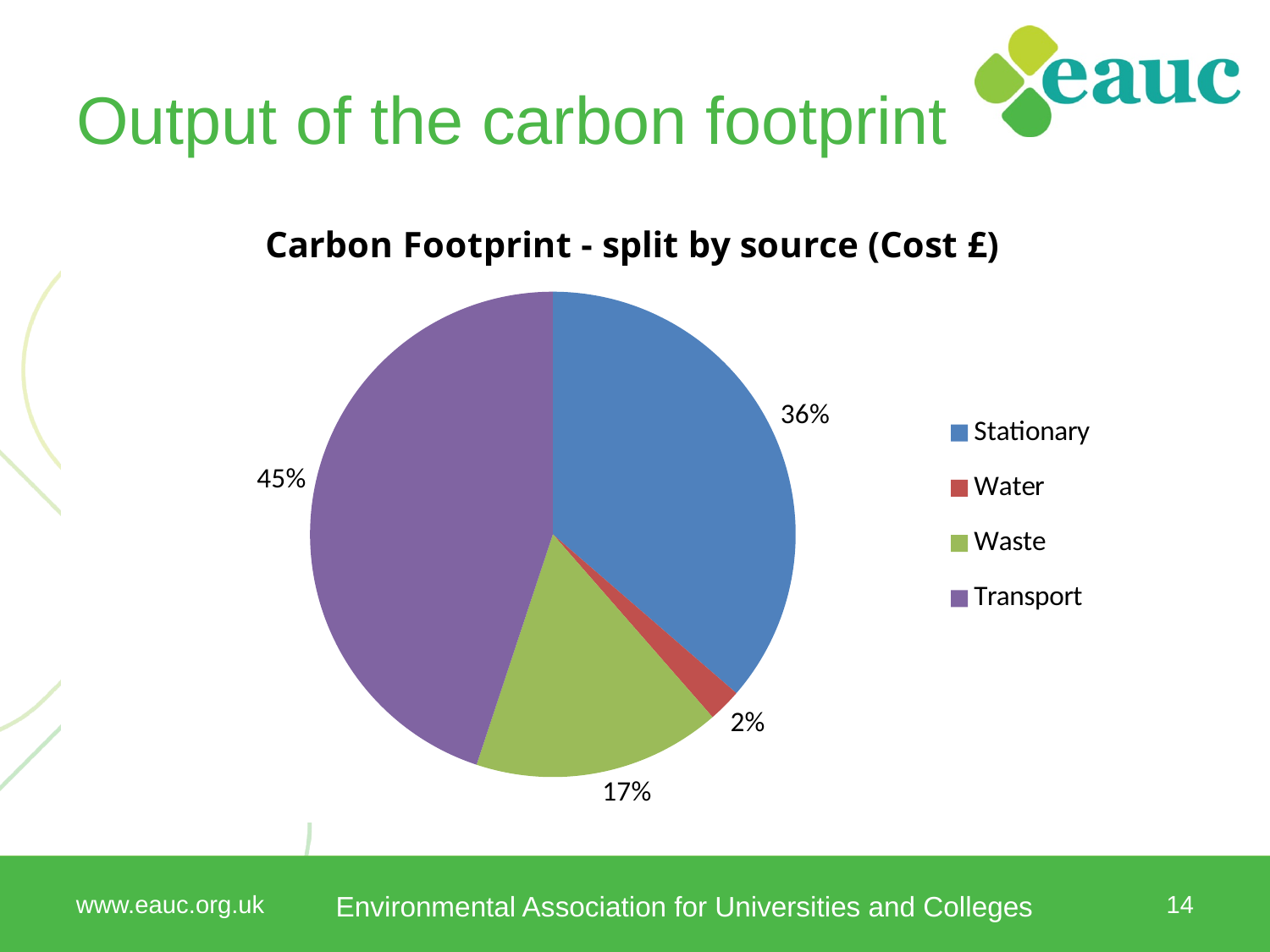
What is the difference in percentage points between the Transport and Stationary shares? 9 What share of the pie does Waste account for? 17% What share of the pie does Transport account for? 45% What is the title of the chart? Carbon Footprint - split by source (Cost £) Which source has the smallest share of the carbon footprint? Water What share of the pie does Water account for? 2% Which has a larger share, Waste or Stationary? Stationary Which source has the largest share of the carbon footprint? Transport How many categories does the pie chart show? 4 Which colour represents Waste in the legend? green What type of chart is shown on the slide? pie chart